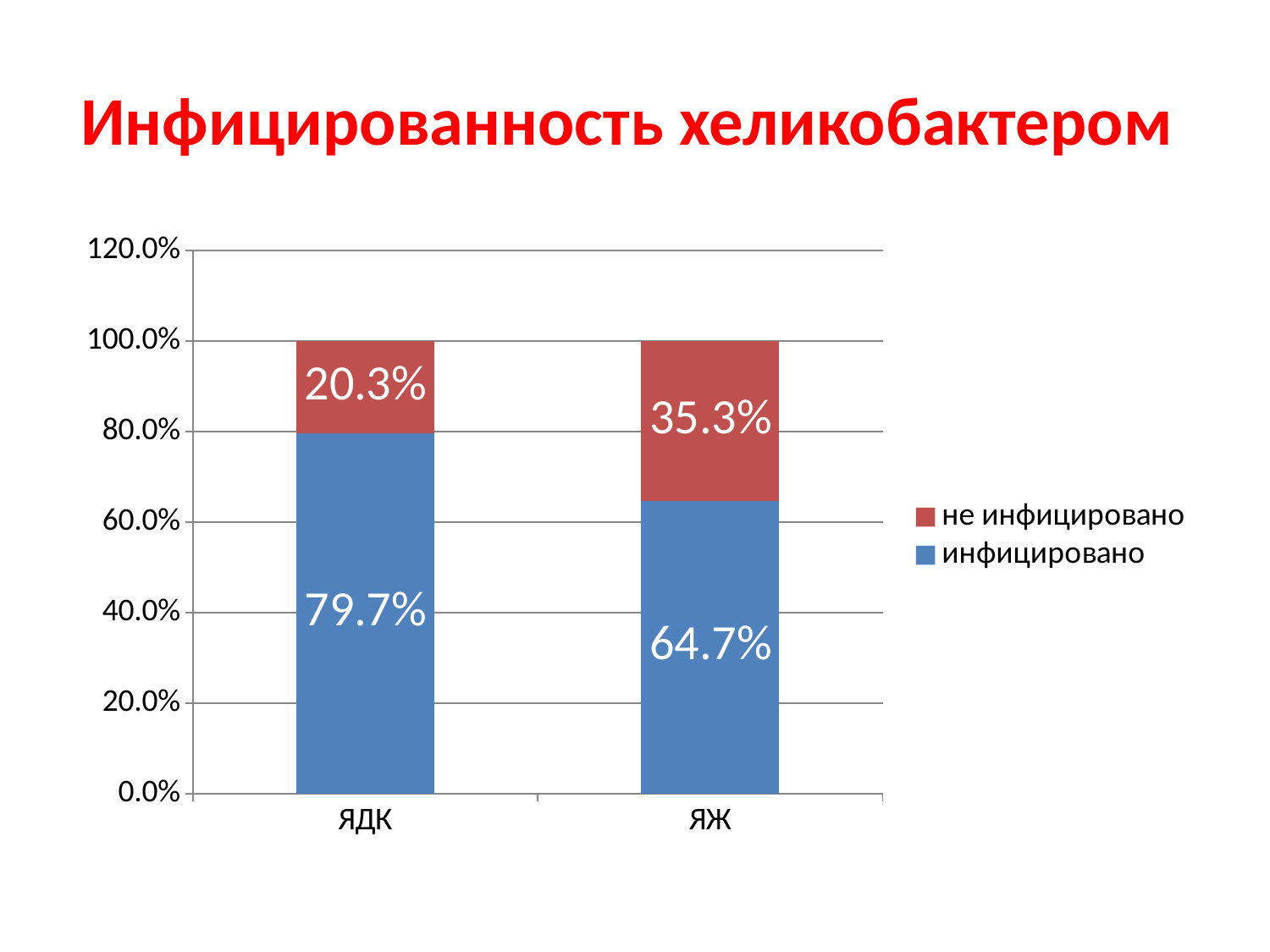
What is the total of the stacked bar for ЯЖ? 100.0% What is the value for "инфицировано" in the ЯДК category? 79.7% Which category has the lower value for "не инфицировано"? ЯДК Which category has the higher value for "инфицировано"? ЯДК How many series does the legend list? 2 How many categories are shown on the x axis? 2 Is the "не инфицировано" value larger for ЯДК or for ЯЖ? ЯЖ What kind of chart is shown on the slide? Stacked bar chart What is the value for "не инфицировано" in the ЯДК category? 20.3% What is the difference between the "инфицировано" values for ЯДК and ЯЖ? 15.0% What is the value for "инфицировано" in the ЯЖ category? 64.7% What is the value for "не инфицировано" in the ЯЖ category? 35.3%